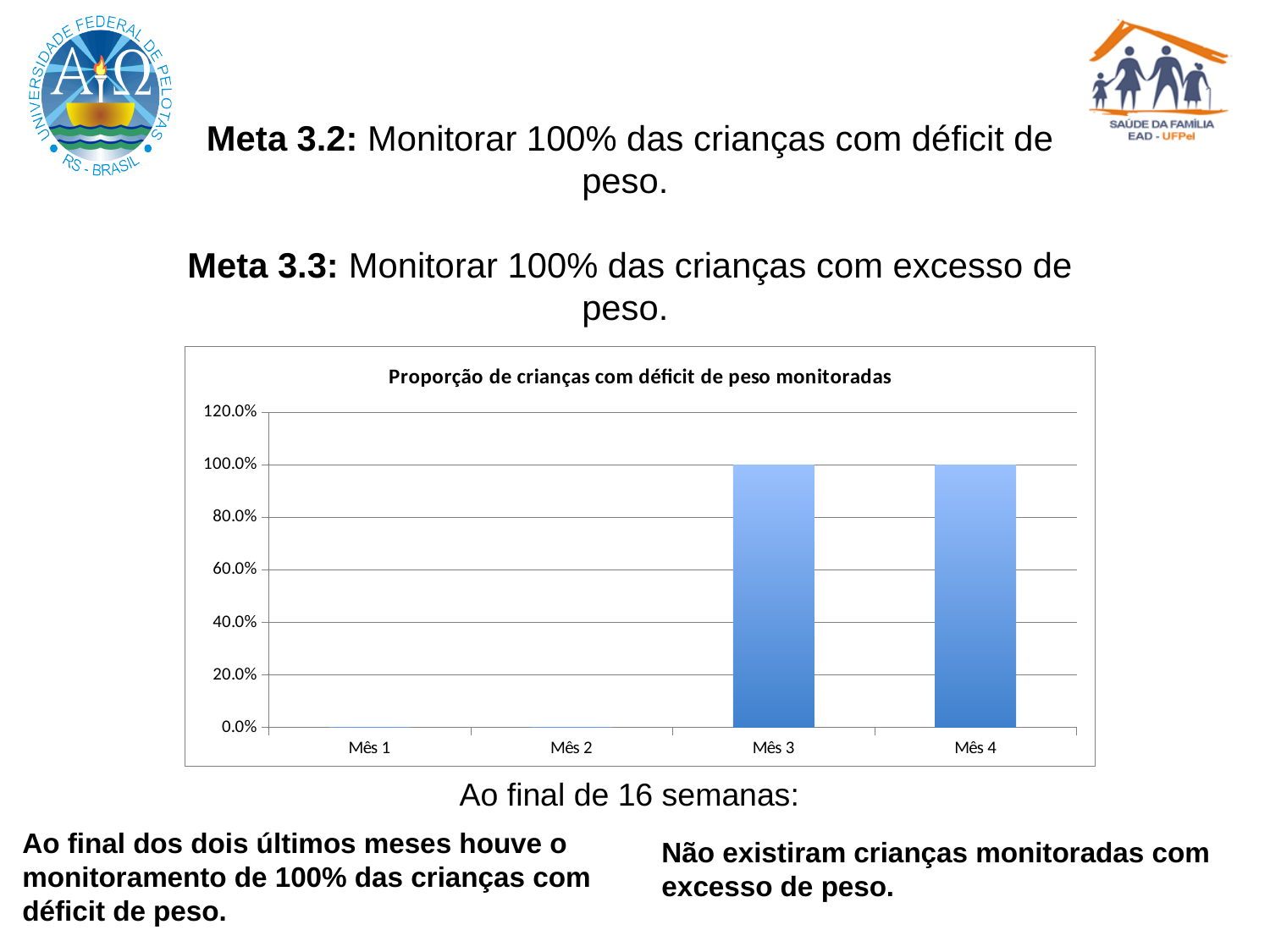
What is the value for Mês 4 in the chart? 100.0% How many months (categories) are shown on the x axis of the chart? 4 Which is larger, the value for Mês 2 or the value for Mês 3? Mês 3 What is the title of the chart? Proporção de crianças com déficit de peso monitoradas Do the values rise or fall from Mês 1 to Mês 4? rise What is the difference between the value for Mês 3 and the value for Mês 1? 100.0% Which is larger, the value for Mês 4 or the value for Mês 1? Mês 4 What is the value for Mês 3 in the chart? 100.0% What kind of chart is shown on the slide? bar chart Is the value for Mês 2 greater or less than 20.0%? less Is the value for Mês 4 greater or less than 80.0%? greater What is the value for Mês 1 in the chart? 0.0%